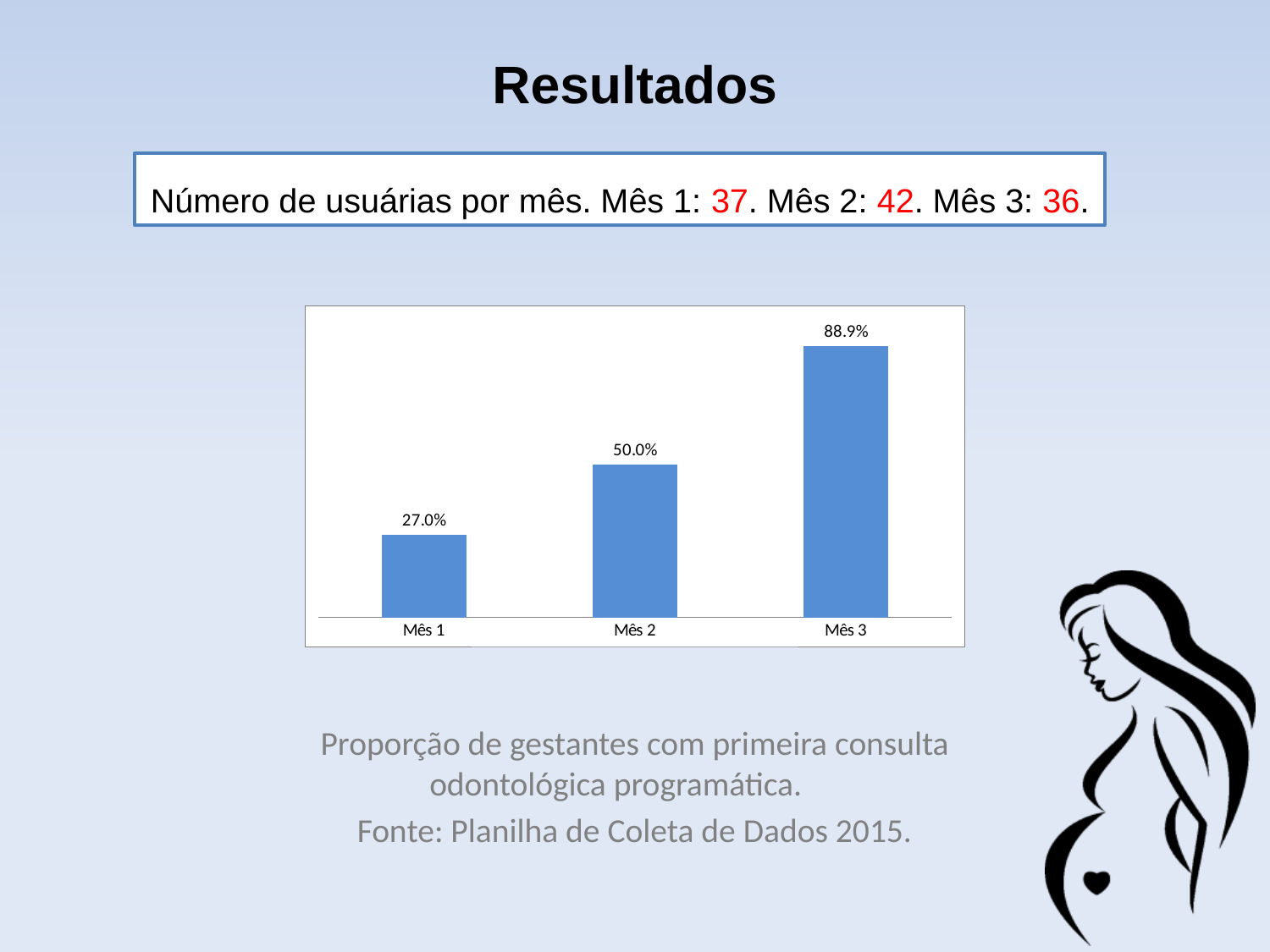
Which is larger, the value for Mês 1 or the value for Mês 2? Mês 2 What is the value for Mês 3? 88.9% What is the value for Mês 2? 50.0% Which month has the lowest value? Mês 1 How many categories are shown on the x axis? 3 What is the difference between the values for Mês 2 and Mês 1? 23.0% What is the value for Mês 1? 27.0% According to the caption below the chart, what does the chart show? Proporção de gestantes com primeira consulta odontológica programática Which month has the highest value? Mês 3 Do the values rise or fall from Mês 1 to Mês 3? Rise What is the difference between the values for Mês 3 and Mês 2? 38.9% What kind of chart is shown on the slide? Bar chart